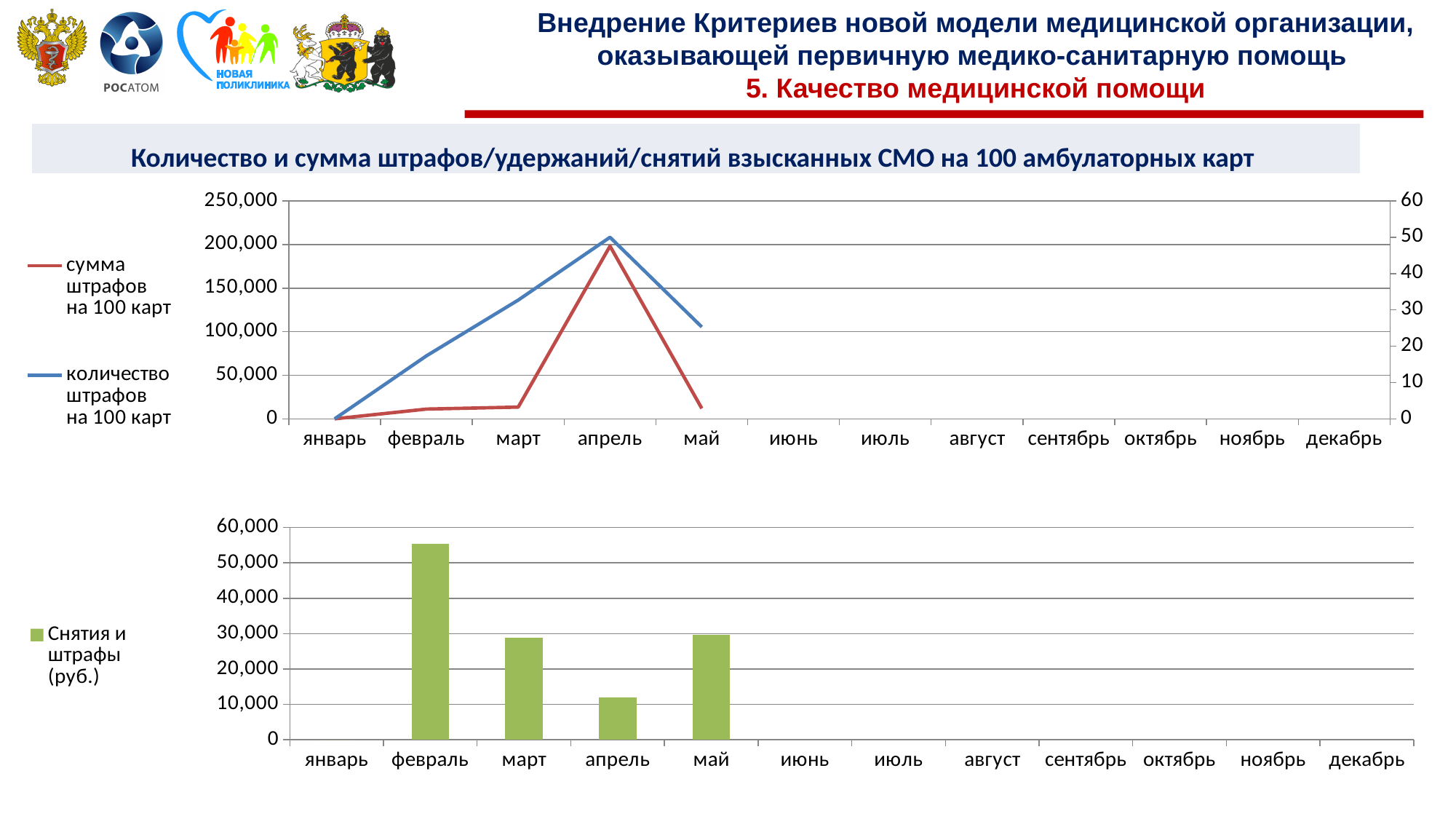
In the lower chart, which is larger, the value for февраль or the value for март? февраль In the lower chart, which month has the tallest bar? февраль In the upper chart, is the value of the red line (сумма штрафов на 100 карт) for май greater or less than 50,000? less How many month categories are shown on the x axis of the lower chart? 12 What type of chart is the upper chart on the slide? line chart In the upper chart, in which month does the red line (сумма штрафов на 100 карт) reach its highest point? апрель What type of chart is the lower chart on the slide? bar chart In the upper chart, does the blue line (количество штрафов на 100 карт) rise or fall from январь to апрель? rise In the lower chart, is the value for февраль greater or less than 50,000? greater How many series does the legend of the upper chart list? 2 In the lower chart, is the value for апрель greater or less than 20,000? less